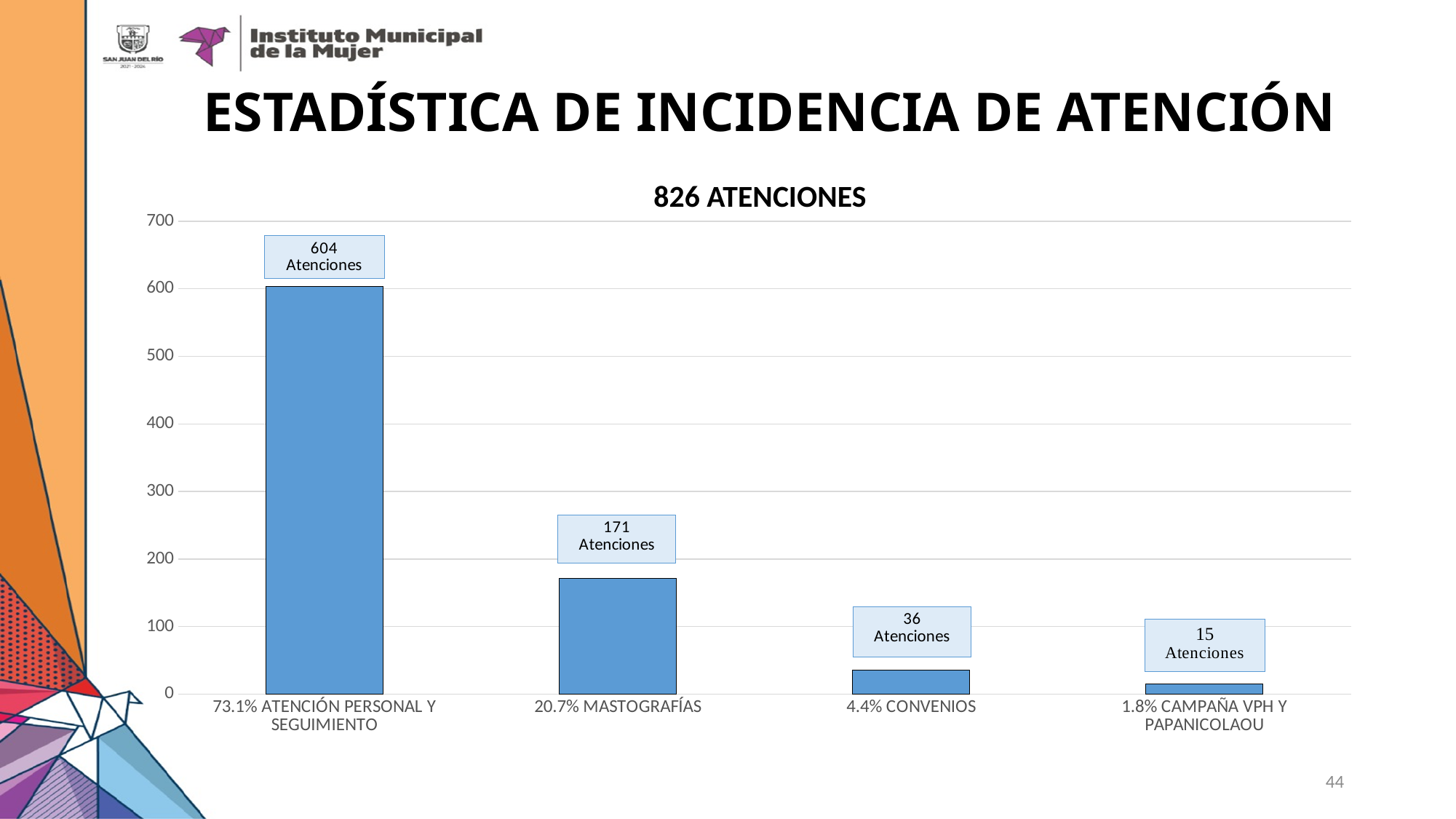
How many atenciones are shown for 20.7% MASTOGRAFÍAS? 171 What is the difference in atenciones between ATENCIÓN PERSONAL Y SEGUIMIENTO and MASTOGRAFÍAS? 433 How many atenciones are shown for 73.1% ATENCIÓN PERSONAL Y SEGUIMIENTO? 604 What is the difference in atenciones between CONVENIOS and CAMPAÑA VPH Y PAPANICOLAOU? 21 Which category has the highest number of atenciones? 73.1% ATENCIÓN PERSONAL Y SEGUIMIENTO What is the title of the chart? 826 ATENCIONES How many atenciones are shown for 4.4% CONVENIOS? 36 Which has more atenciones, MASTOGRAFÍAS or CONVENIOS? MASTOGRAFÍAS Which category has the lowest number of atenciones? 1.8% CAMPAÑA VPH Y PAPANICOLAOU How many categories are shown in the chart? 4 What kind of chart is shown on the slide? Bar chart How many atenciones are shown for 1.8% CAMPAÑA VPH Y PAPANICOLAOU? 15